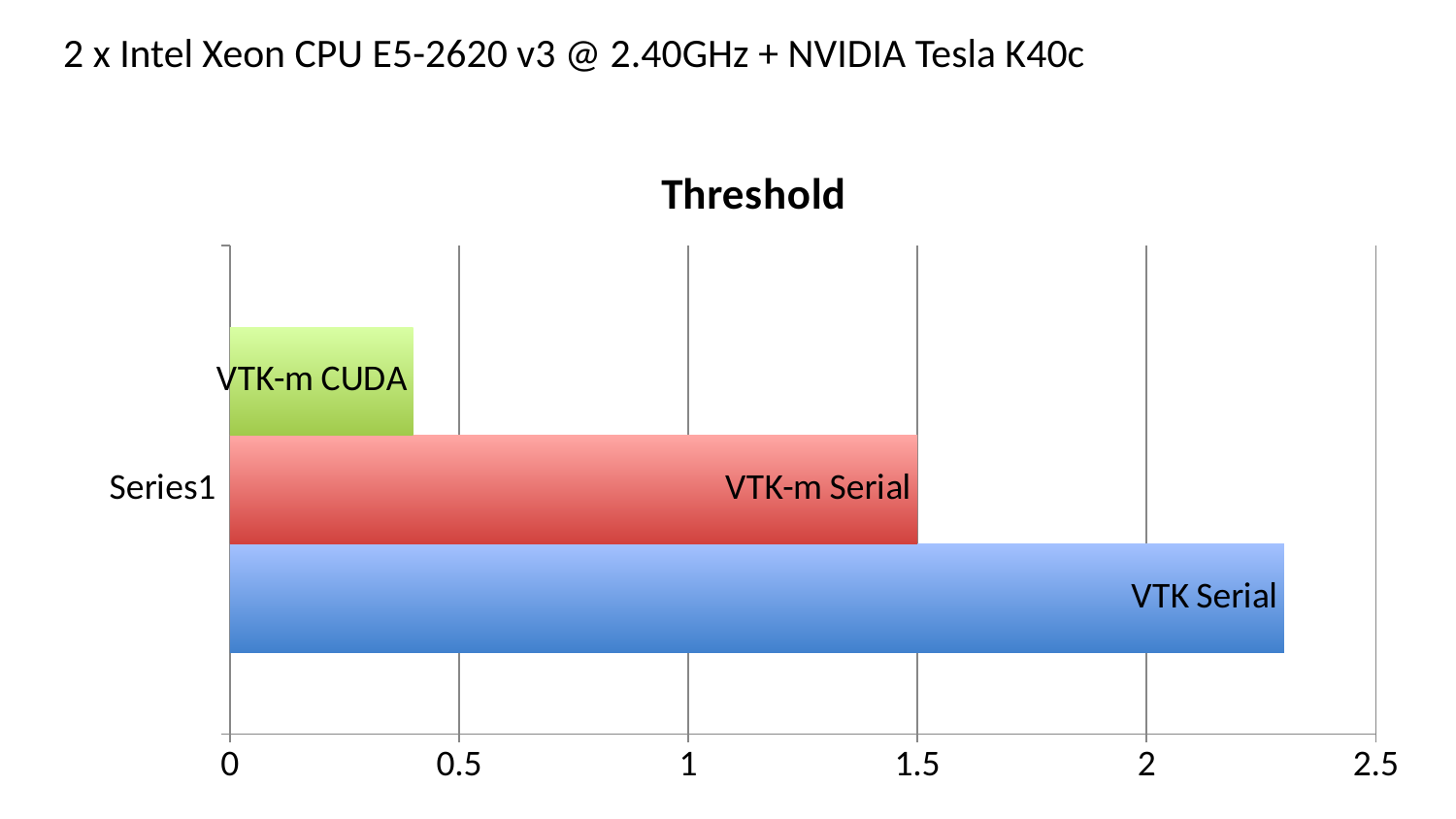
How many bars are plotted in the chart? 3 Is the value for VTK Serial greater or less than 2.5? less Which bar has the lowest value? VTK-m CUDA Which is larger, the value for VTK Serial or the value for VTK-m Serial? VTK Serial What is the title of the chart? Threshold Is the value for VTK Serial greater or less than 2? greater What is the value for VTK-m Serial? 1.5 Which is larger, the value for VTK-m CUDA or the value for VTK-m Serial? VTK-m Serial What colour is the VTK-m CUDA bar? green Is the value for VTK-m CUDA greater or less than 0.5? less What kind of chart is shown on the slide? bar chart Which bar has the highest value? VTK Serial